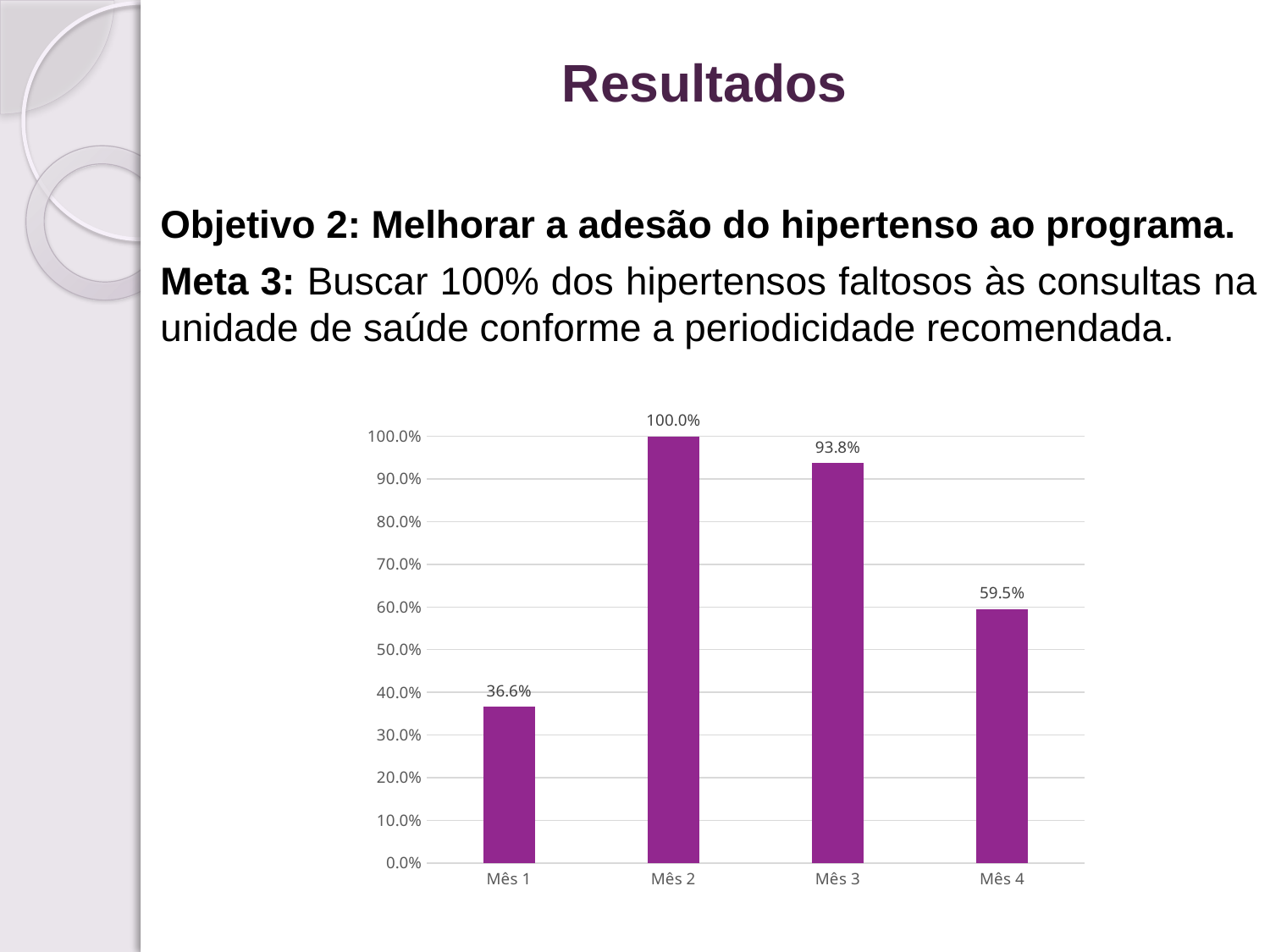
Which month has the highest value? Mês 2 What is the value for Mês 1? 36.6% What is the difference between the values for Mês 4 and Mês 1? 22.9% How many months are shown on the x axis? 4 What is the difference between the values for Mês 2 and Mês 3? 6.2% Which is larger, the value for Mês 3 or the value for Mês 4? Mês 3 What is the value for Mês 3? 93.8% Is the value for Mês 1 greater or less than 40.0%? less What is the value for Mês 4? 59.5% What kind of chart is shown on the slide? bar chart What is the value for Mês 2? 100.0% Which month has the lowest value? Mês 1